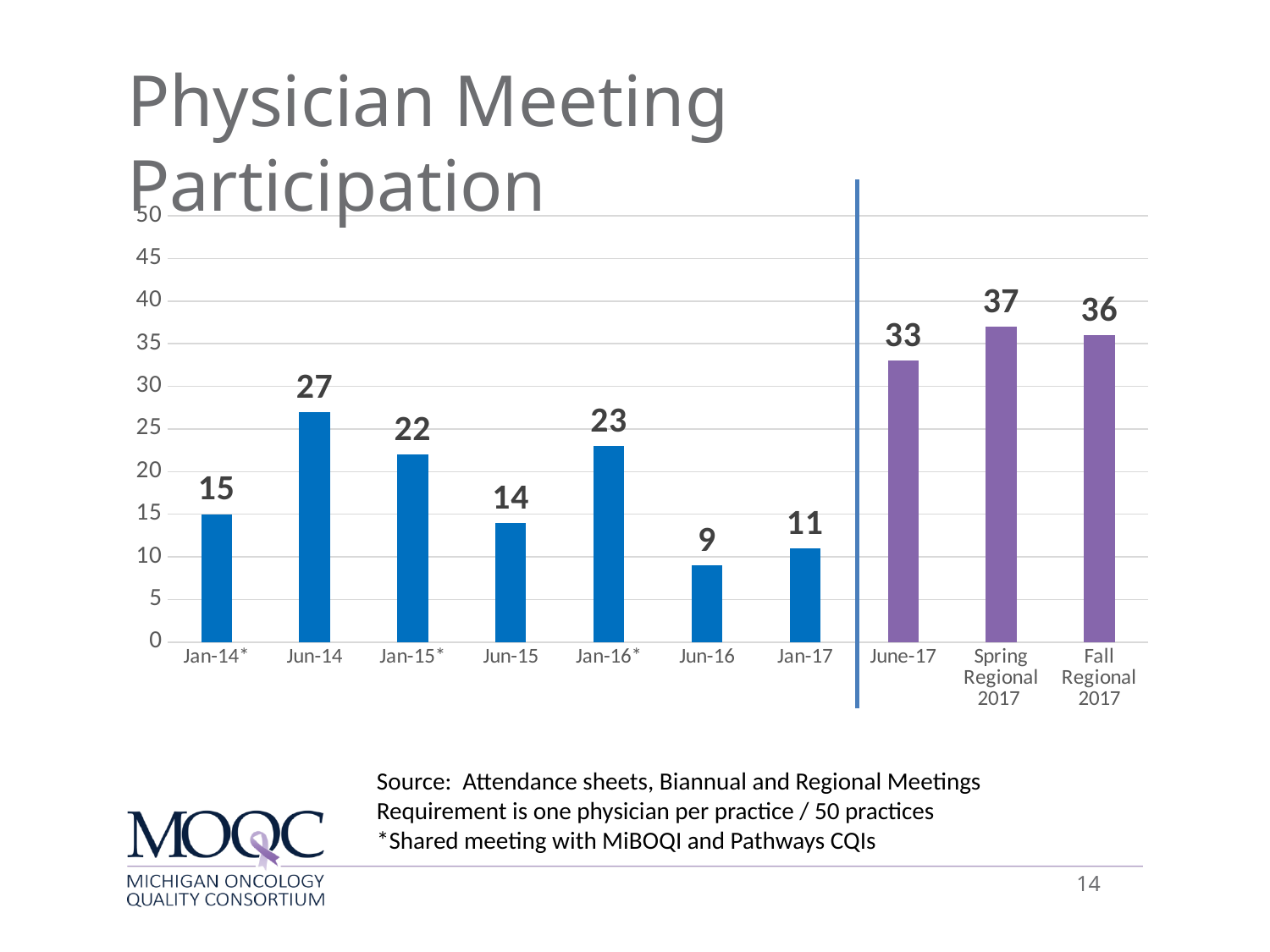
Do the values rise or fall from Jan-16* to Jun-16? fall What is the difference between the values for Fall Regional 2017 and Jan-17? 25 Is the value for June-17 greater or less than 30? greater Which category has the highest value? Spring Regional 2017 Which category has the lowest value? Jun-16 What is the value for Jun-14? 27 How many categories are shown on the x axis? 10 What is the value for Jun-16? 9 What is the value for Spring Regional 2017? 37 Which is larger, the value for Jan-15* or the value for Jan-16*? Jan-16* What is the title of the chart? Physician Meeting Participation What kind of chart is shown on the slide? bar chart